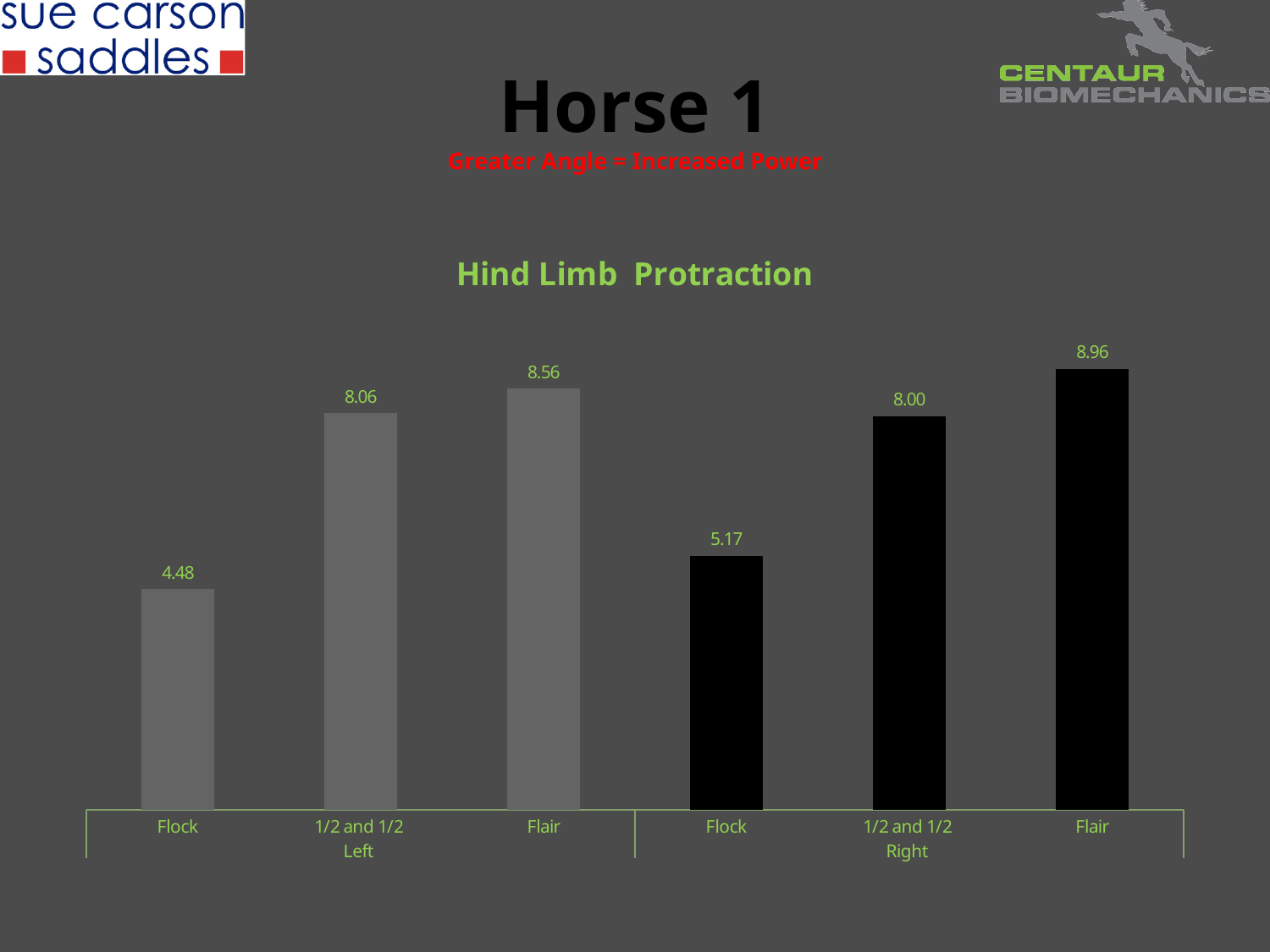
Within the Right group, do the values rise or fall from Flock to Flair? Rise What is the difference between Flair and Flock in the Right group? 3.79 What is the difference between Flair and Flock in the Left group? 4.08 Which is larger, 1/2 and 1/2 Left or 1/2 and 1/2 Right? 1/2 and 1/2 Left What kind of chart is shown? Bar chart Which bar has the highest value on the chart? Flair (Right) How many bars are plotted on the chart? 6 What is the value for Flock in the Left group? 4.48 Which bar has the lowest value on the chart? Flock (Left) What is the value for Flair in the Right group? 8.96 What is the value for 1/2 and 1/2 in the Right group? 8.00 What is the title of the chart? Hind Limb Protraction